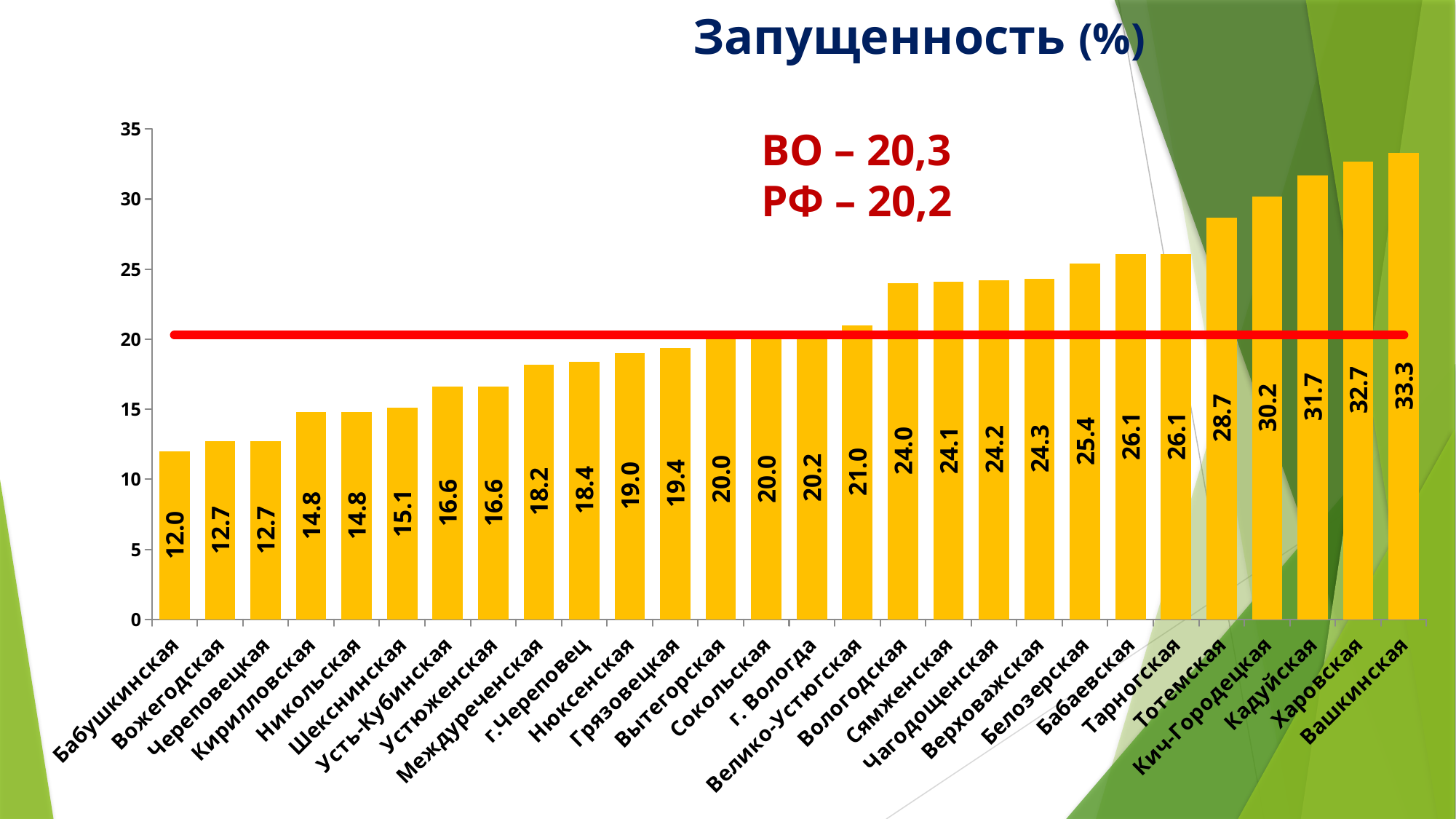
What is the value for г. Вологда? 20.2 What is the value for Бабушкинская? 12.0 What is the difference between the values for Вашкинская and Бабушкинская? 21.3 Which category has the lowest value? Бабушкинская What is the difference between the values for Кадуйская and Белозерская? 6.3 How many categories are shown on the x axis? 28 What is the title of the chart? Запущенность (%) Which category has the highest value? Вашкинская Which is larger, the value for Харовская or the value for Кич-Городецкая? Харовская What is the value for Тотемская? 28.7 Is the value for Велико-Устюгская greater or less than 20? greater What kind of chart is shown on the slide? bar chart